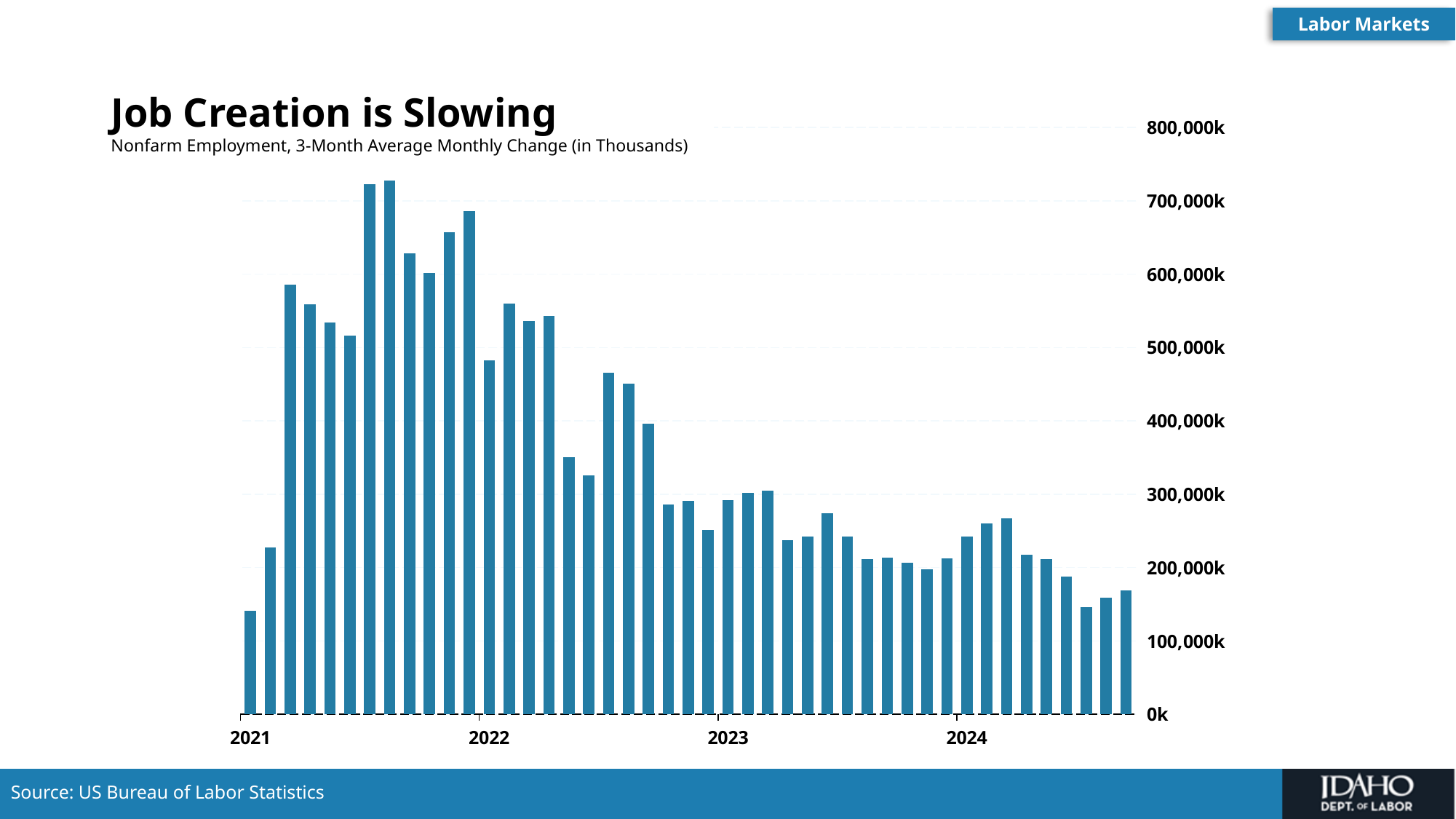
In which year does the tallest bar occur? 2021 Is the value of the tallest bar greater or less than 700,000k? greater Is the value of the first bar in 2022 greater or less than 600,000k? less What is the highest value shown on the vertical axis? 800,000k Is the value of the first bar in 2021 greater or less than 200,000k? less Which is larger, the first bar of 2022 or the first bar of 2023? the first bar of 2022 What is the subtitle of the chart? Nonfarm Employment, 3-Month Average Monthly Change (in Thousands) Overall, do the bars rise or fall from 2021 to 2024? fall What is the title of the chart? Job Creation is Slowing What kind of chart is shown on the slide? bar chart